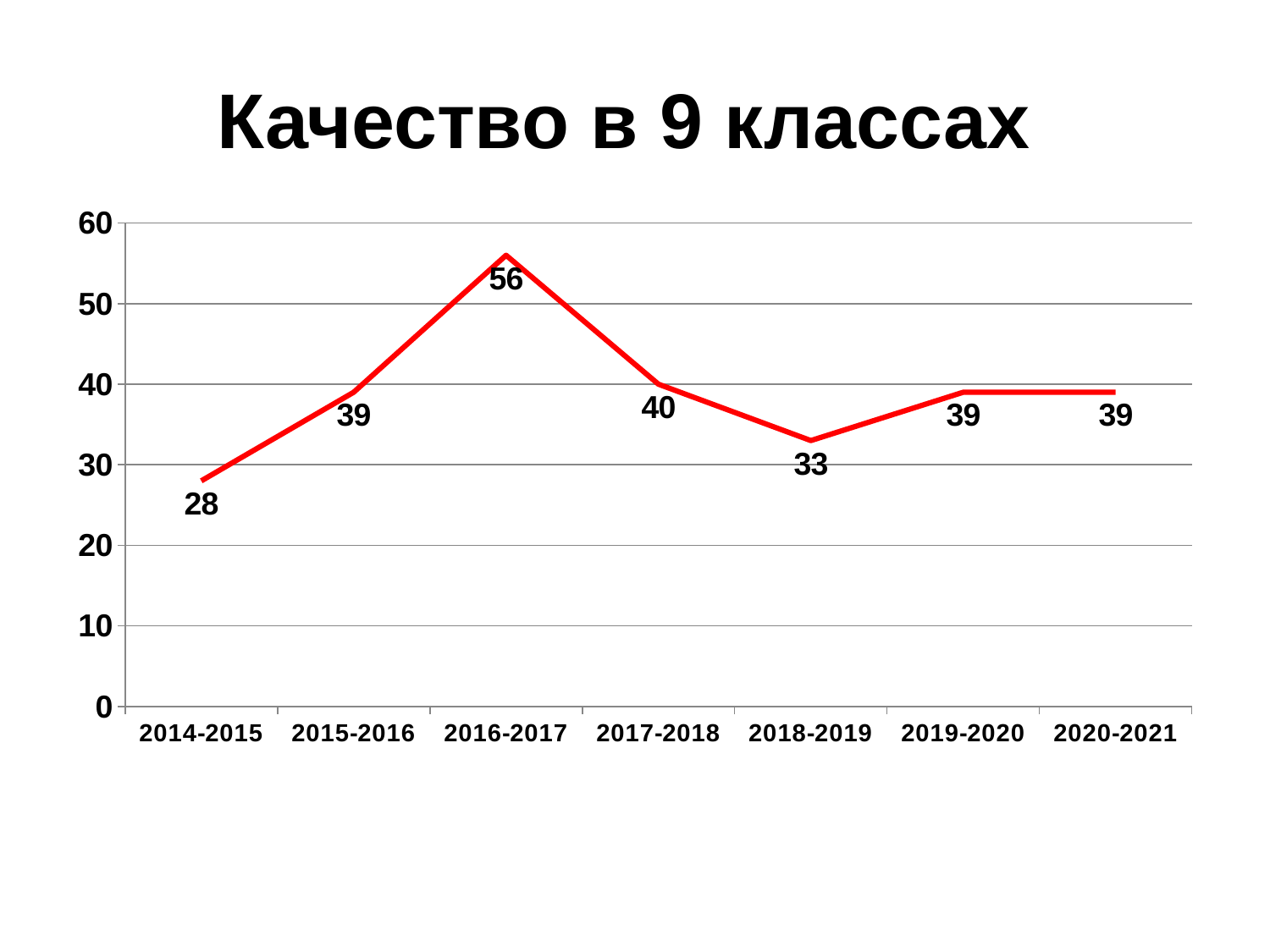
What is the value for 2016-2017? 56 Which school year has the lowest value? 2014-2015 What is the value for 2014-2015? 28 What is the title of the chart? Качество в 9 классах Which school year has the highest value? 2016-2017 What is the difference between the values for 2016-2017 and 2014-2015? 28 Which is larger, the value for 2017-2018 or the value for 2018-2019? 2017-2018 What is the value for 2020-2021? 39 What is the value for 2018-2019? 33 What is the difference between the values for 2017-2018 and 2018-2019? 7 What kind of chart is shown on the slide? line chart How many school years are plotted on the chart? 7